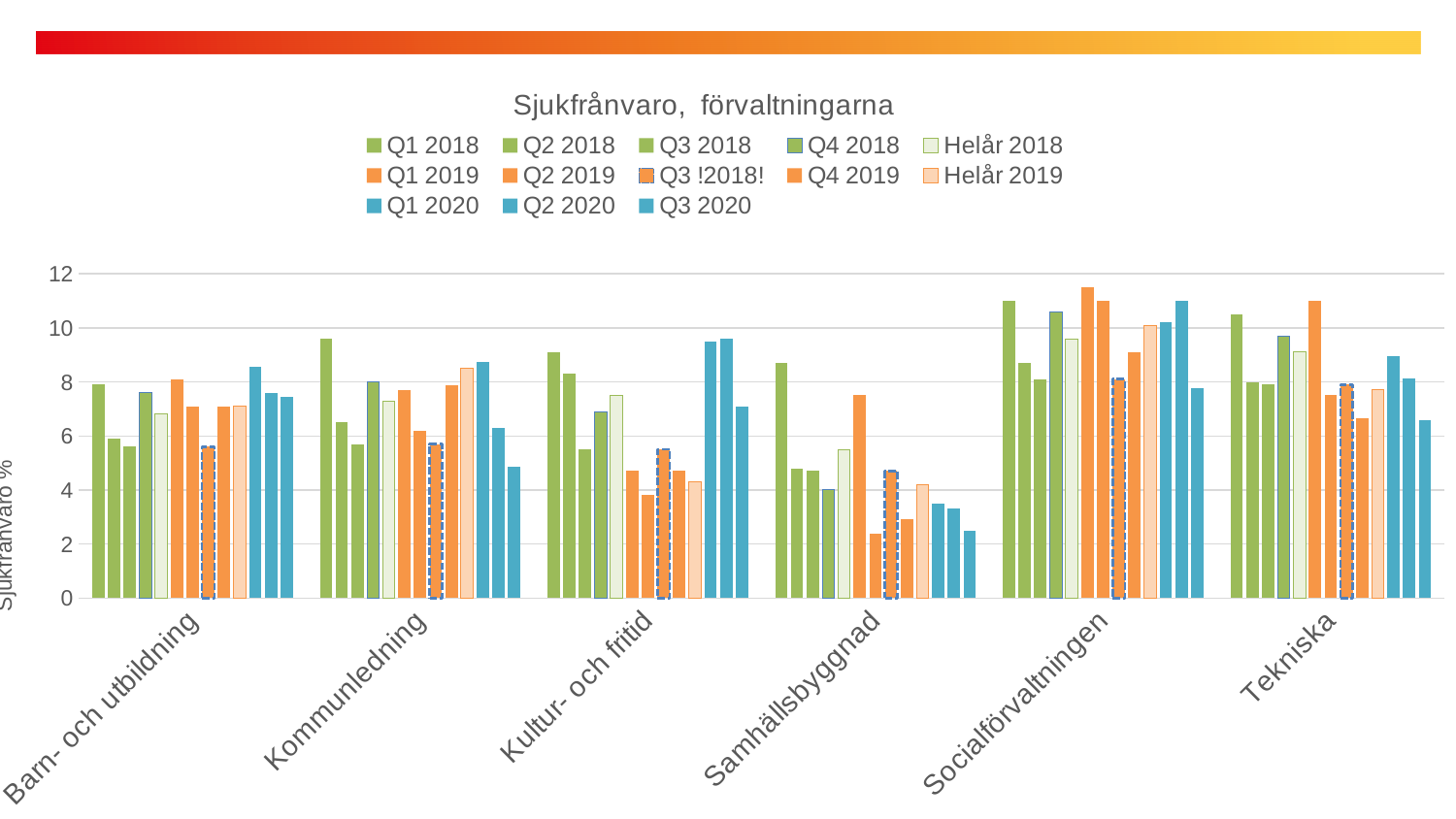
What kind of chart is shown on the slide? bar chart Is the Q1 2019 value for Socialförvaltningen greater or less than 10? greater What is the title of the chart? Sjukfrånvaro, förvaltningarna Is the Q2 2019 value for Samhällsbyggnad greater or less than 4? less How many categories (förvaltningar) are shown on the x axis? 6 Which is larger, the Q1 2018 value for Kommunledning or the Q1 2018 value for Barn- och utbildning? Kommunledning Is the Q1 2020 value for Kultur- och fritid greater or less than 8? greater Which category has the highest Q1 2019 value? Socialförvaltningen How many series does the legend list? 13 What is the label on the vertical axis? Sjukfrånvaro % Which category has the lowest Q2 2019 value? Samhällsbyggnad